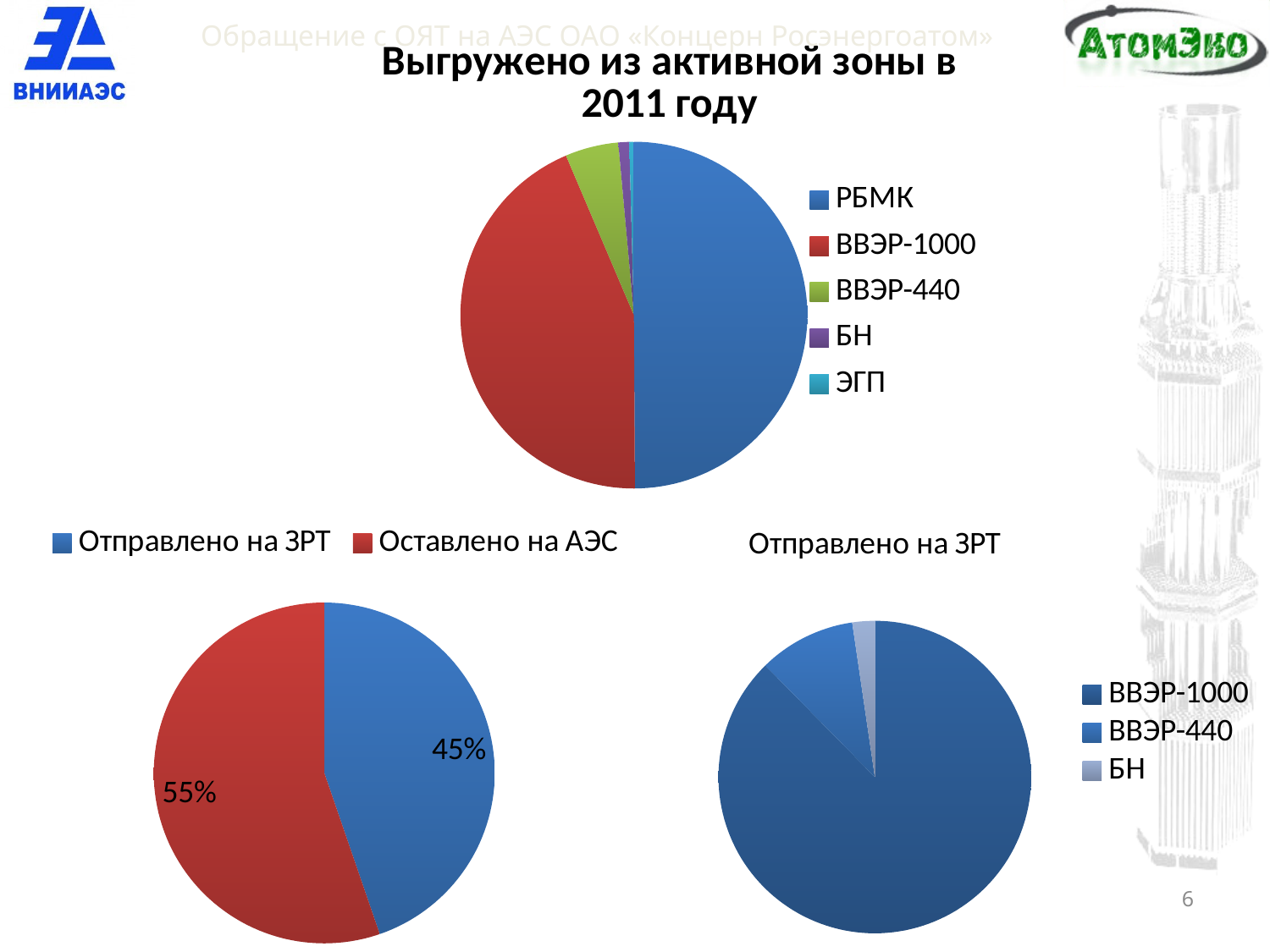
In the bottom-left pie chart, what is the difference in percentage points between "Оставлено на АЭС" and "Отправлено на ЗРТ"? 10% In the chart titled "Выгружено из активной зоны в 2011 году", which is larger, the slice for ВВЭР-1000 or the slice for ВВЭР-440? ВВЭР-1000 How many categories does the legend of the chart titled "Выгружено из активной зоны в 2011 году" list? 5 What kind of chart is the chart titled "Выгружено из активной зоны в 2011 году"? pie chart In the chart titled "Выгружено из активной зоны в 2011 году", which category has the largest slice? РБМК In the bottom-left pie chart, which category has the larger share? Оставлено на АЭС How many categories does the legend of the bottom-left pie chart list? 2 How many categories does the legend of the chart titled "Отправлено на ЗРТ" list? 3 In the bottom-left pie chart, what share is labelled for "Оставлено на АЭС"? 55% In the chart titled "Отправлено на ЗРТ", which category has the largest slice? ВВЭР-1000 In the chart titled "Отправлено на ЗРТ", which category has the smallest slice? БН In the bottom-left pie chart, what share is labelled for "Отправлено на ЗРТ"? 45%